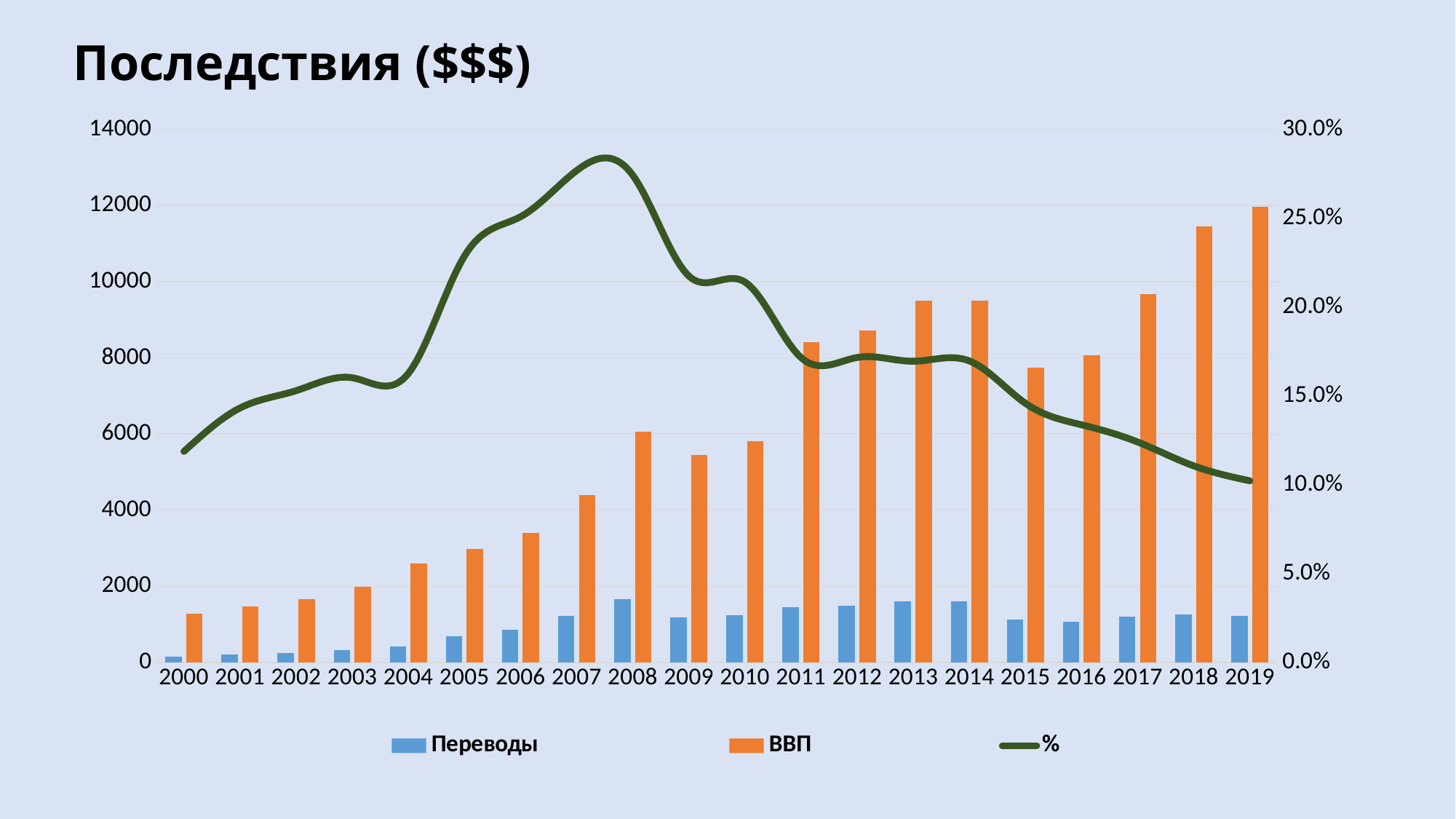
Which is larger, the ВВП value for 2017 or for 2018? 2018 Is the ВВП value for 2009 greater or less than 6000? less How many series does the legend list? 3 Is the % value for 2019 greater or less than 15.0%? less In which year does the % line reach its peak? 2007 In which year is the ВВП bar the highest? 2019 What kind of chart is this? Combined bar and line chart In which year is the ВВП bar the lowest? 2000 How many years are shown on the x axis? 20 What is the title of the chart? Последствия ($$$) Does the ВВП series generally rise or fall from 2000 to 2019? rise Is the ВВП value for 2019 greater or less than 10000? greater